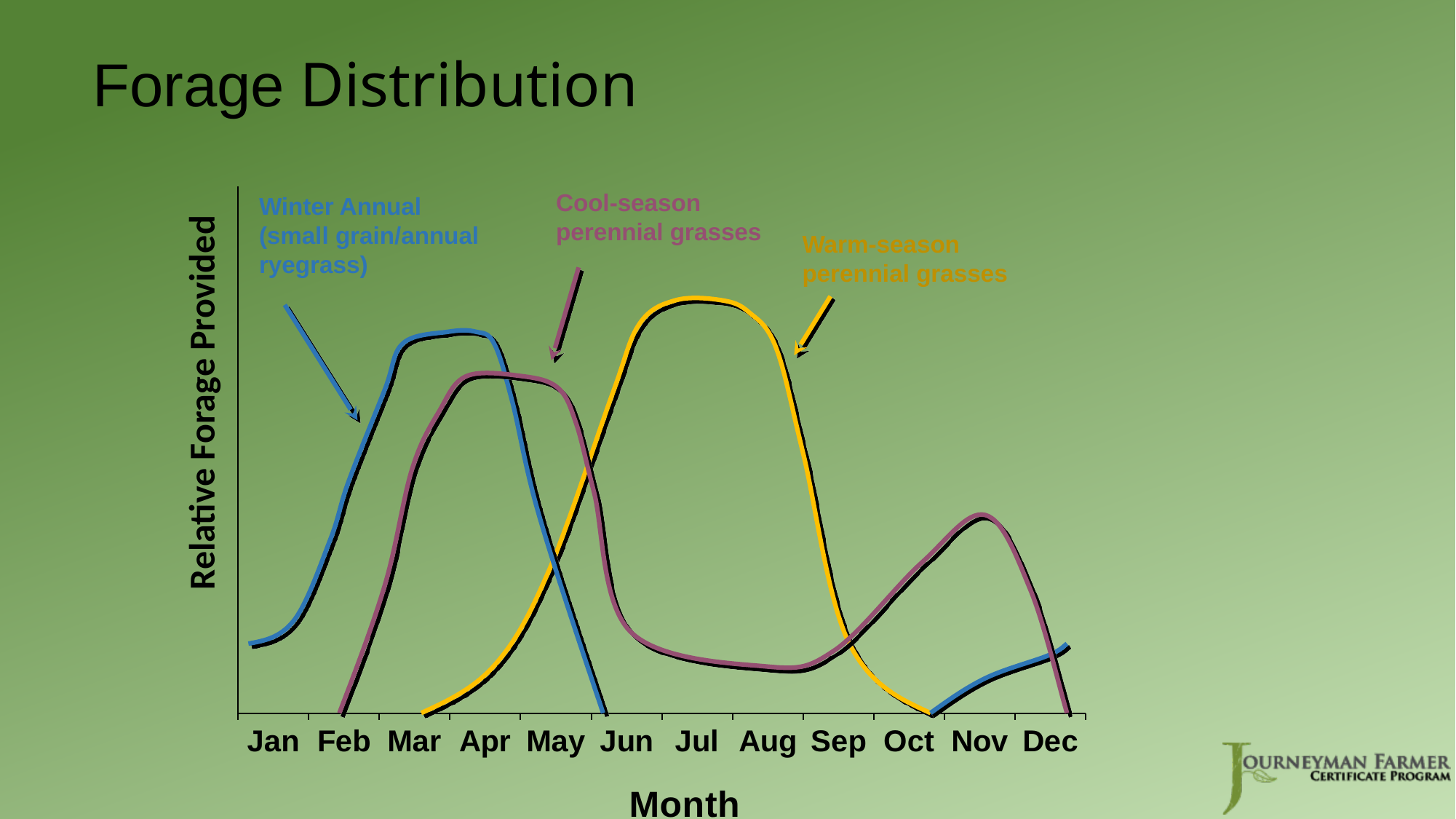
What is the label of the y axis? Relative Forage Provided In Jul, which provides more forage: warm-season perennial grasses or cool-season perennial grasses? Warm-season perennial grasses In Mar, which provides more forage: winter annual or warm-season perennial grasses? Winter annual What kind of chart is shown on the slide? line chart How many months are labelled along the x axis? 12 What is the title of the chart? Forage Distribution Which forage type shows a second, smaller peak in Nov? Cool-season perennial grasses Which forage type reaches the highest peak on the chart? Warm-season perennial grasses In which month do warm-season perennial grasses reach their peak? Jul Does the winter annual line rise or fall from Jan to Mar? rise How many forage types (series) are plotted on the chart? 3 Does the warm-season perennial grasses line rise or fall from Aug to Oct? fall